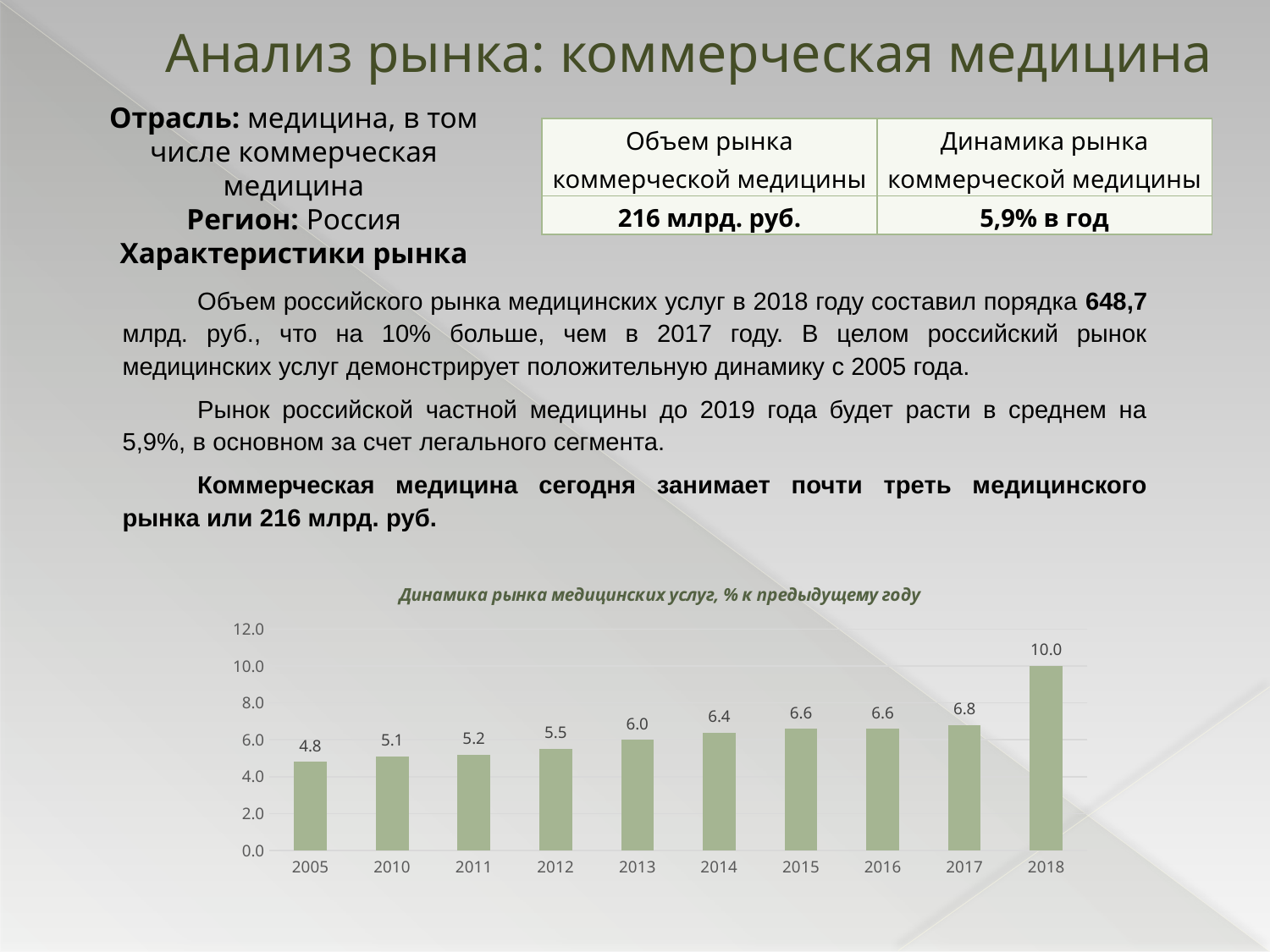
Do the values in the chart rise or fall from 2005 to 2018? rise What kind of chart is shown on the slide? bar chart Is the value for 2011 greater or less than 6.0? less What is the value for 2013 in the chart? 6.0 How many years are shown on the x axis of the chart? 10 What is the value for 2005 in the chart? 4.8 What is the difference between the values for 2018 and 2017? 3.2 What is the value for 2018 in the chart? 10.0 Which year has the lowest value in the chart? 2005 Which year has the highest value in the chart? 2018 Which is larger, the value for 2012 or the value for 2014? 2014 What is the title of the chart? Динамика рынка медицинских услуг, % к предыдущему году